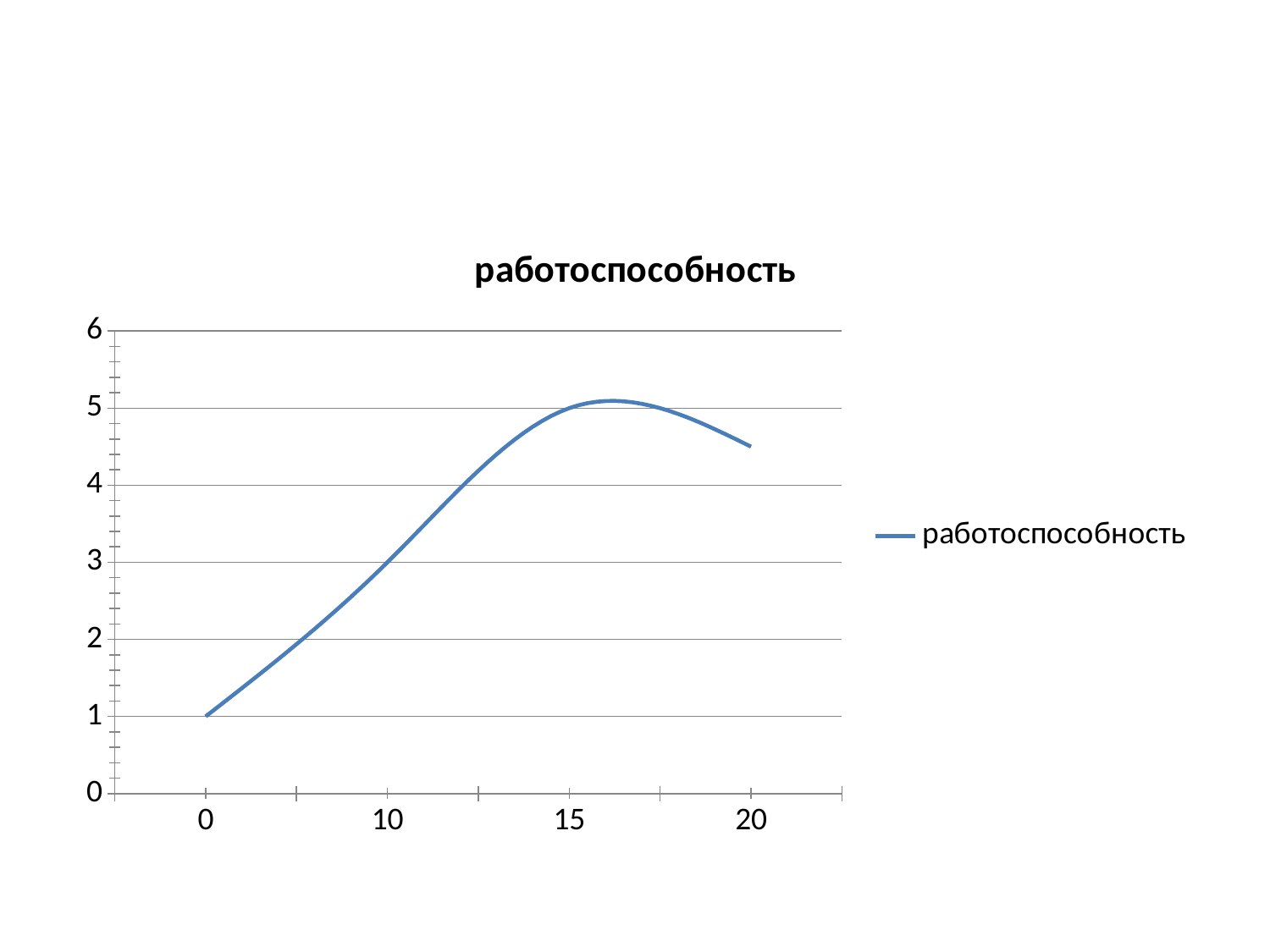
What is the value of работоспособность at x = 0? 1 How does работоспособность change along the x axis? rises, then falls after 15 At which x value is работоспособность lowest? 0 Is the value for x = 10 greater or less than 2? greater What is the title of the chart? работоспособность At which x value is работоспособность highest? 15 Is the value for x = 20 greater or less than 4? greater Which is larger, the value at x = 20 or the value at x = 0? x = 20 What kind of chart is shown on the slide? line chart How many points are plotted on the line? 4 Is the value for x = 15 greater or less than 4? greater How many series does the legend list? 1